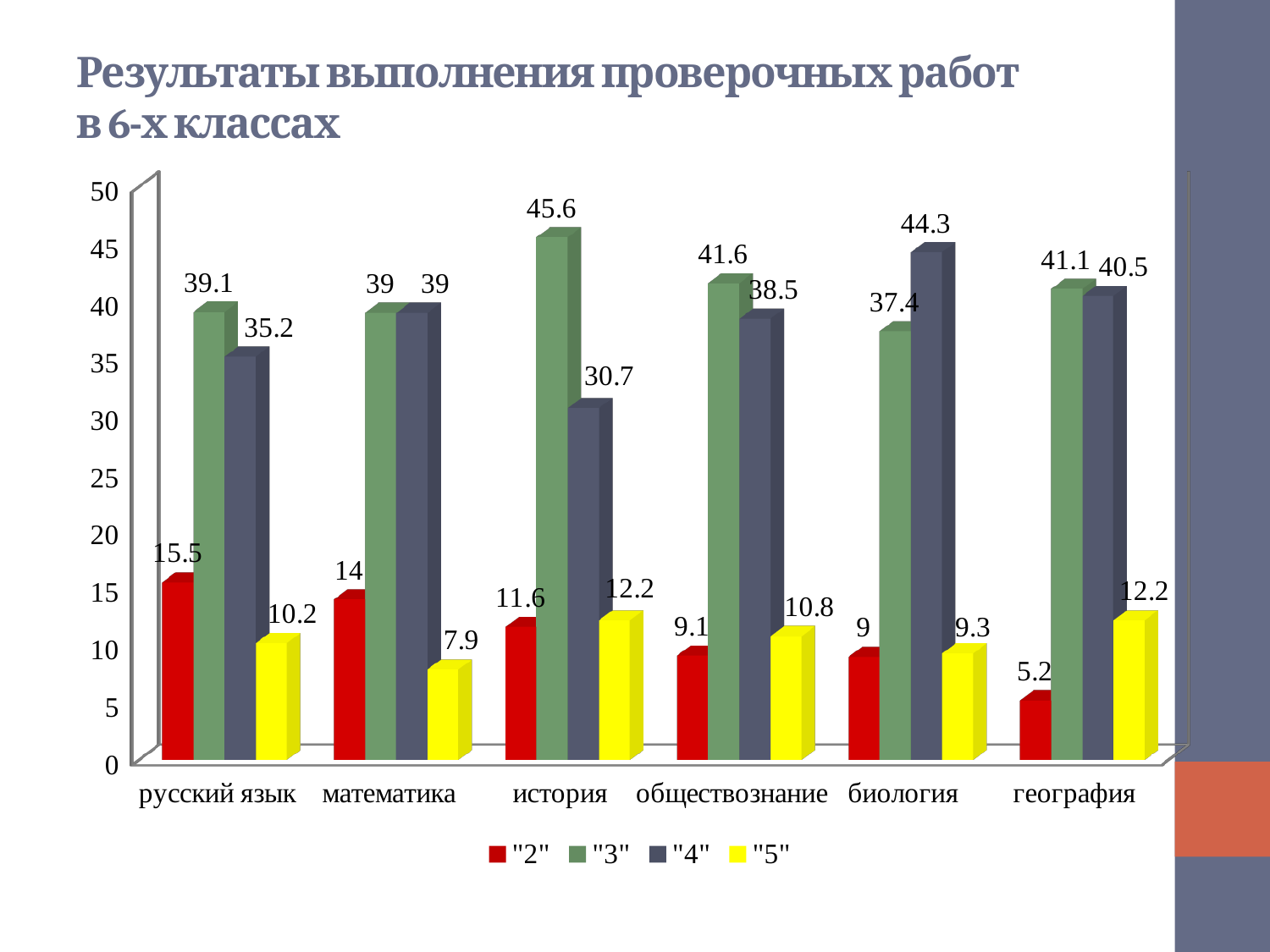
What is the value for "5" in математика? 7.9 How many subjects are shown on the x axis? 6 What is the value for "4" in биология? 44.3 What is the difference between the "3" and "4" values in история? 14.9 How many series does the legend list? 4 Which is larger in обществознание: the value for "3" or the value for "4"? "3" Which subject has the highest value for "2"? русский язык Which subject has the lowest value for "3"? биология What is the value for "2" in география? 5.2 Do the values for "2" rise or fall from русский язык to география? fall What kind of chart is shown on the slide? bar chart What is the value for "3" in история? 45.6